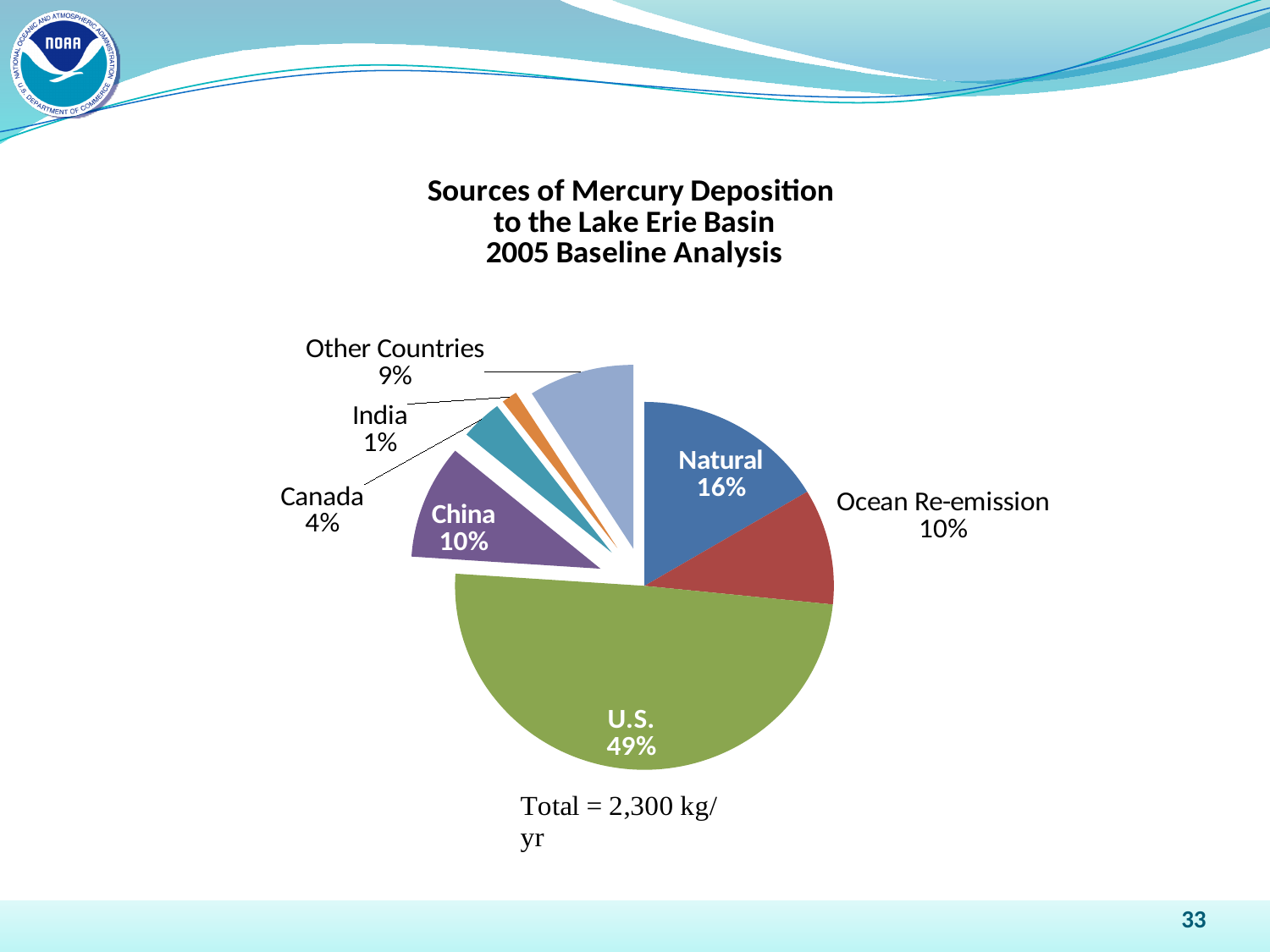
What is the difference in percentage points between the U.S. share and the Natural share? 33 What total annual deposition is stated below the pie chart? 2,300 kg/yr What percentage is shown for India? 1% What share does China contribute according to the pie chart? 10% What percentage of the pie is attributed to Natural sources? 16% What share is attributed to Canada? 4% How many slices does the pie chart have? 7 What share of mercury deposition to the Lake Erie Basin comes from the U.S.? 49% Which source has the smallest slice of the pie? India What percentage is shown for Ocean Re-emission? 10% Which source has the largest slice of the pie? U.S. Which is larger, the share for Other Countries or the share for Canada? Other Countries